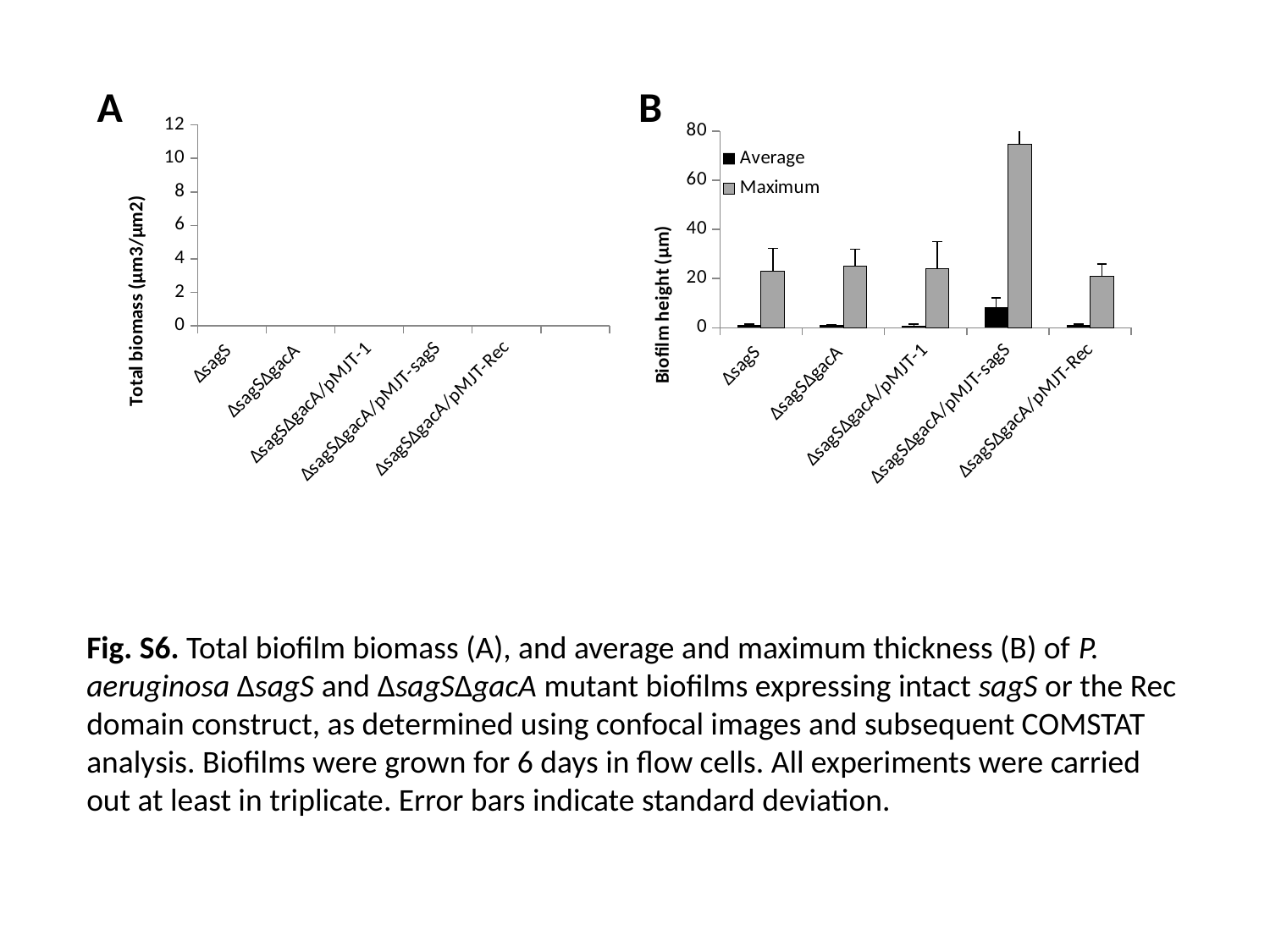
In chart B, is the Maximum value for ΔsagSΔgacA/pMJT-Rec greater or less than 40? less In chart B, is the Maximum value for ΔsagSΔgacA/pMJT-sagS greater or less than 60? greater What kind of chart is chart B (Biofilm height)? bar chart In chart B, which category has the highest Maximum biofilm height? ΔsagSΔgacA/pMJT-sagS How many categories are shown on the x axis of chart B? 5 What is the y-axis label of chart A? Total biomass (µm3/µm2) In chart B, which is larger: the Maximum value for ΔsagSΔgacA/pMJT-sagS or the Maximum value for ΔsagS? ΔsagSΔgacA/pMJT-sagS How many categories are listed on the x axis of chart A? 5 In chart B, which category has the highest Average biofilm height? ΔsagSΔgacA/pMJT-sagS How many series does the legend of chart B list? 2 What are the two series named in the legend of chart B? Average and Maximum In chart B, is the Average value for ΔsagSΔgacA/pMJT-sagS greater or less than 20? less